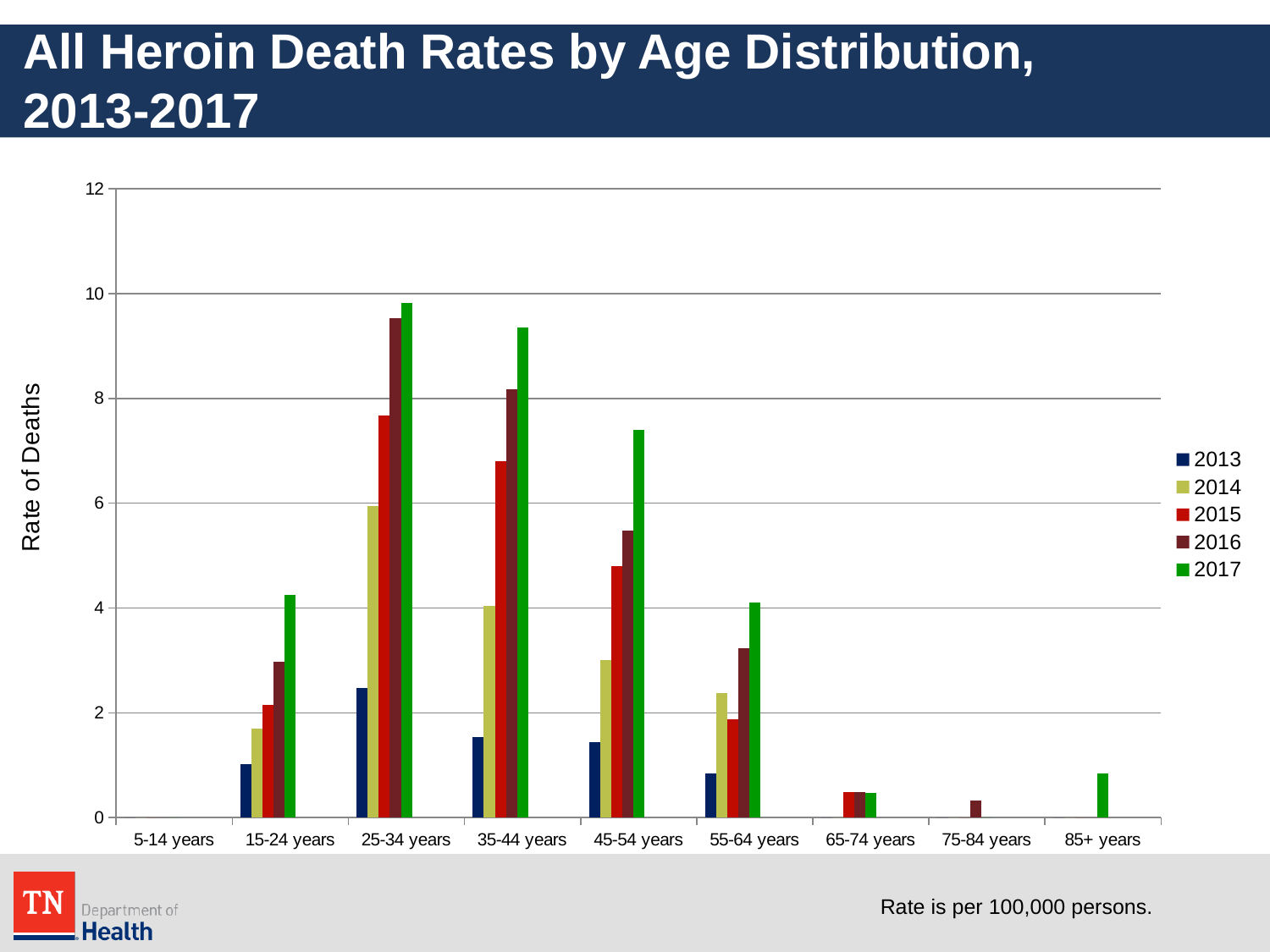
How many series does the legend list? 5 Which is larger for 2017: the value for 35-44 years or the value for 45-54 years? 35-44 years Is the 2017 value for 55-64 years greater or less than 2? greater Is the 2016 value for 45-54 years greater or less than 4? greater How many age groups are shown on the x axis? 9 For the 25-34 years group, do the values rise or fall from 2013 to 2017? rise Which age group has the highest 2017 heroin death rate? 25-34 years Is the 2013 value for 25-34 years greater or less than 4? less What is the title of the y axis? Rate of Deaths For 55-64 years, which is larger: the 2014 value or the 2015 value? 2014 What kind of chart is shown on the slide? bar chart